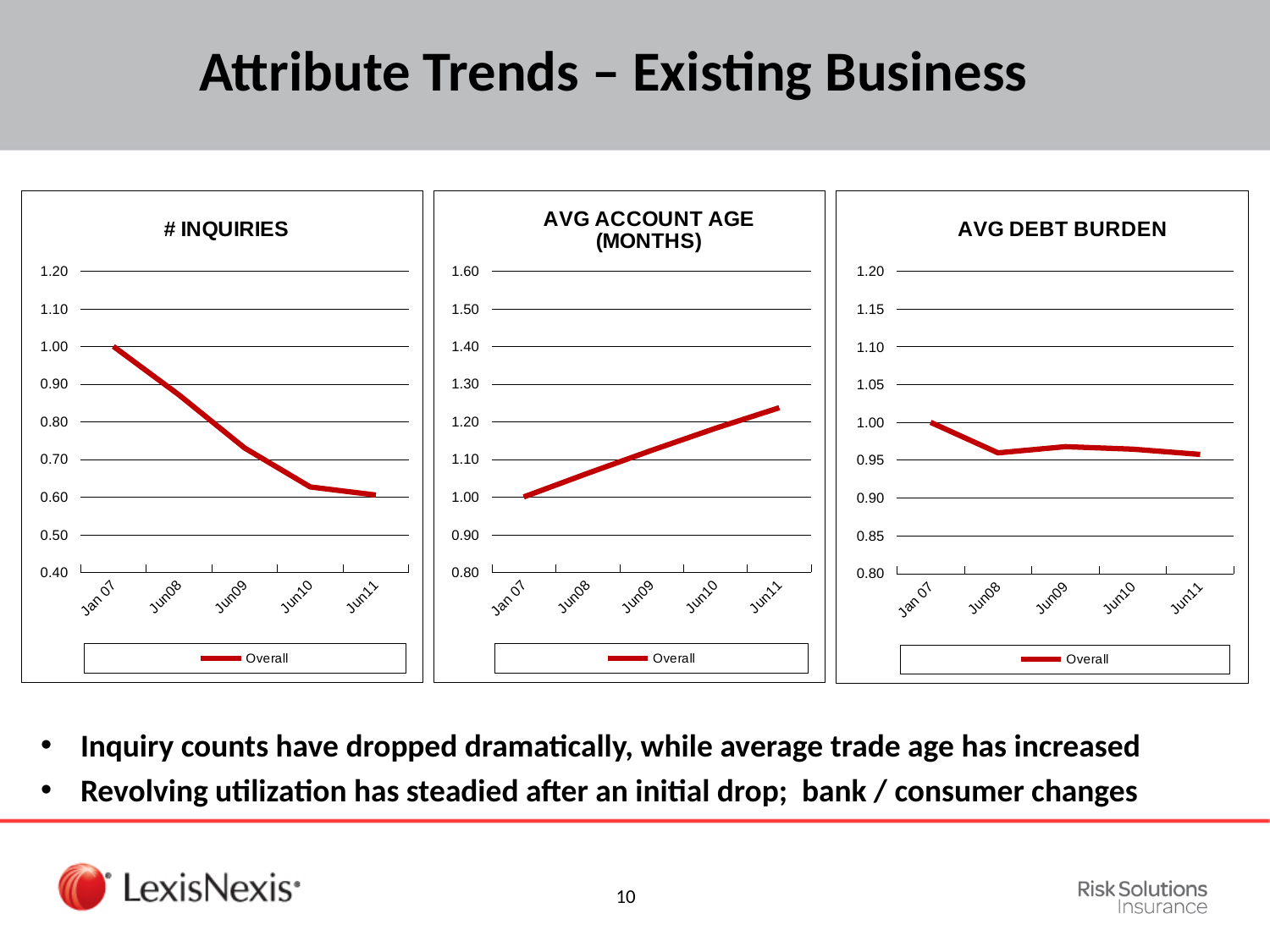
What is the name of the series shown in the legend of the "AVG DEBT BURDEN" chart? Overall On the "AVG ACCOUNT AGE (MONTHS)" chart, do the values rise or fall from Jan 07 to Jun11? rise On the "# INQUIRIES" chart, is the value for Jun11 greater or less than 0.70? less On the "# INQUIRIES" chart, what is the value for Jan 07? 1.00 What kind of chart is the "# INQUIRIES" chart? line chart How many x-axis points are plotted on the "AVG DEBT BURDEN" chart? 5 On the "# INQUIRIES" chart, do the values rise or fall from Jan 07 to Jun11? fall On the "AVG ACCOUNT AGE (MONTHS)" chart, is the value for Jun11 greater or less than 1.20? greater On the "# INQUIRIES" chart, which x-axis point has the lowest value? Jun11 On the "AVG DEBT BURDEN" chart, which x-axis point has the highest value? Jan 07 How many series does the legend of the "AVG ACCOUNT AGE (MONTHS)" chart list? 1 On the "AVG ACCOUNT AGE (MONTHS)" chart, what is the value for Jan 07? 1.00